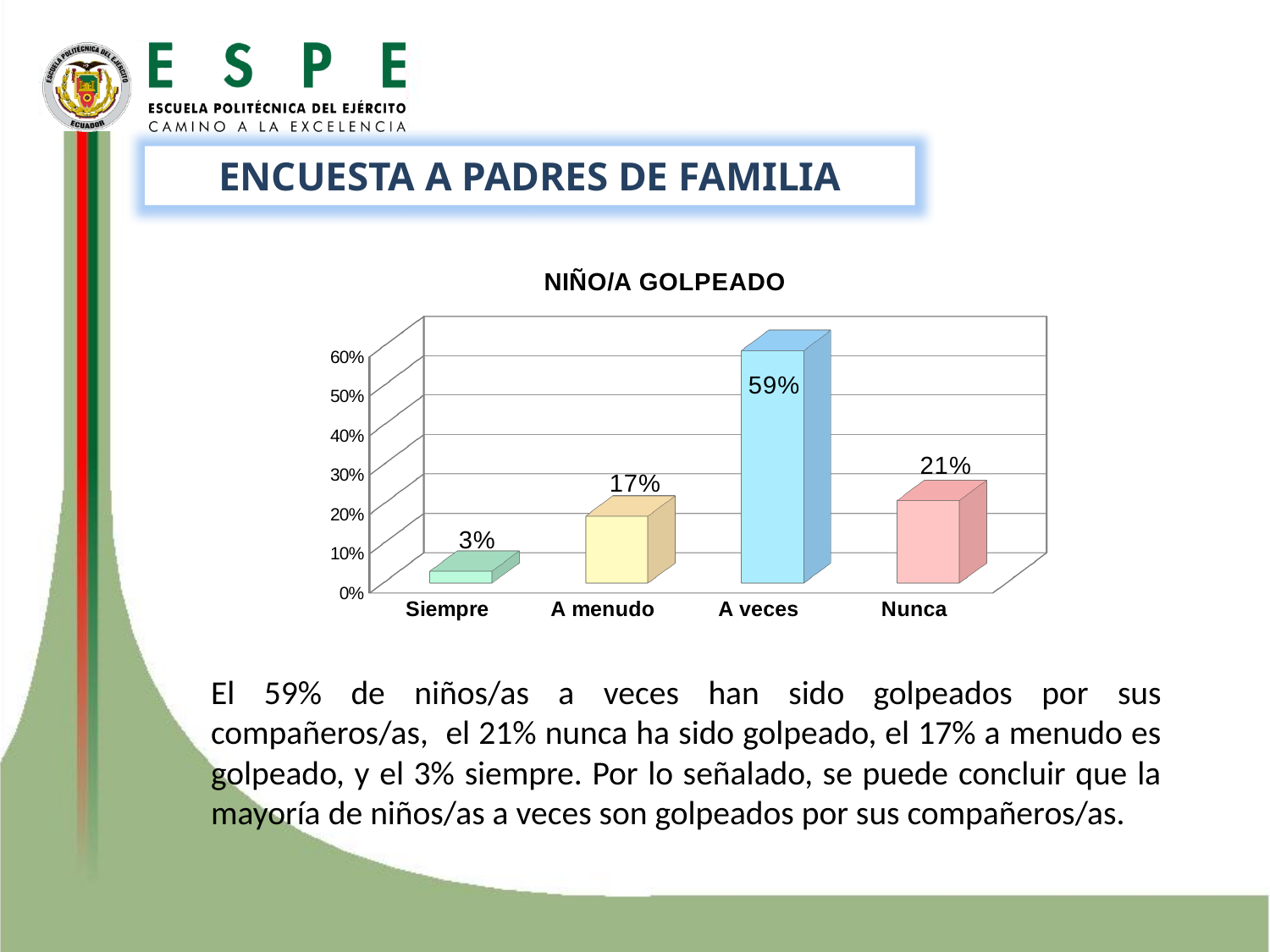
What is the value for Siempre? 3% How many categories are shown on the x axis? 4 What is the title of the chart? NIÑO/A GOLPEADO Which category has the highest value? A veces Which category has the lowest value? Siempre What kind of chart is shown? Bar chart What is the value for Nunca? 21% Which is larger, the value for A menudo or the value for Nunca? Nunca What is the value for A veces? 59% What is the value for A menudo? 17% What is the difference between the values for A veces and Nunca? 38% What is the difference between the values for Nunca and A menudo? 4%